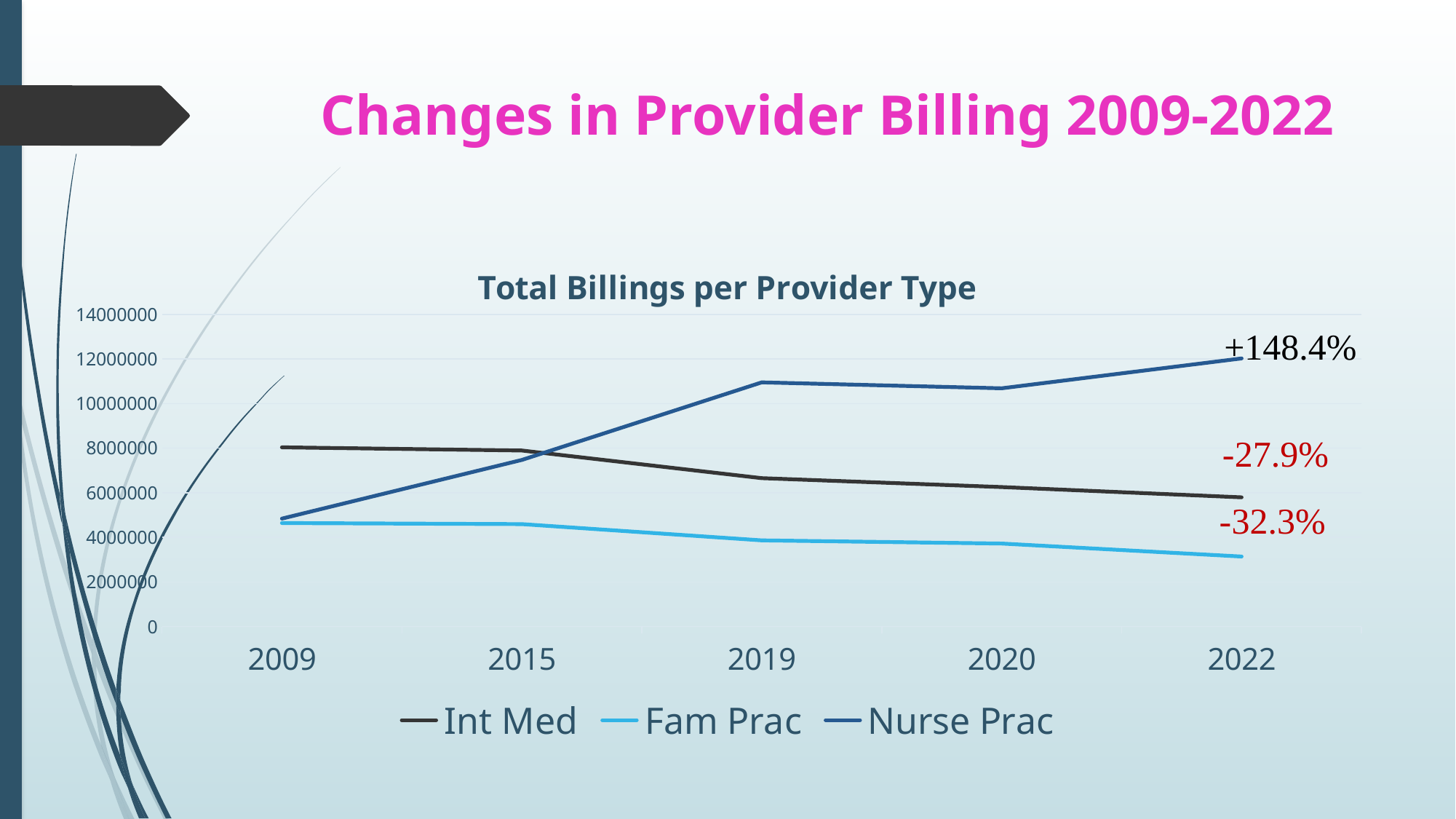
Which provider type has the lowest total billings in 2022? Fam Prac What type of chart is shown on the slide? line chart What percentage change is annotated for the Fam Prac line? -32.3% What percentage change is annotated for the Nurse Prac line? +148.4% Is the value for Nurse Prac in 2019 greater or less than 10000000? greater Which provider type has the highest total billings in 2022? Nurse Prac Do the Fam Prac billings rise or fall from 2009 to 2022? fall What percentage change is annotated for the Int Med line? -27.9% Which provider type has the highest total billings in 2009? Int Med What is the title of the chart? Total Billings per Provider Type How many series does the legend list? 3 How many years are shown on the x axis? 5